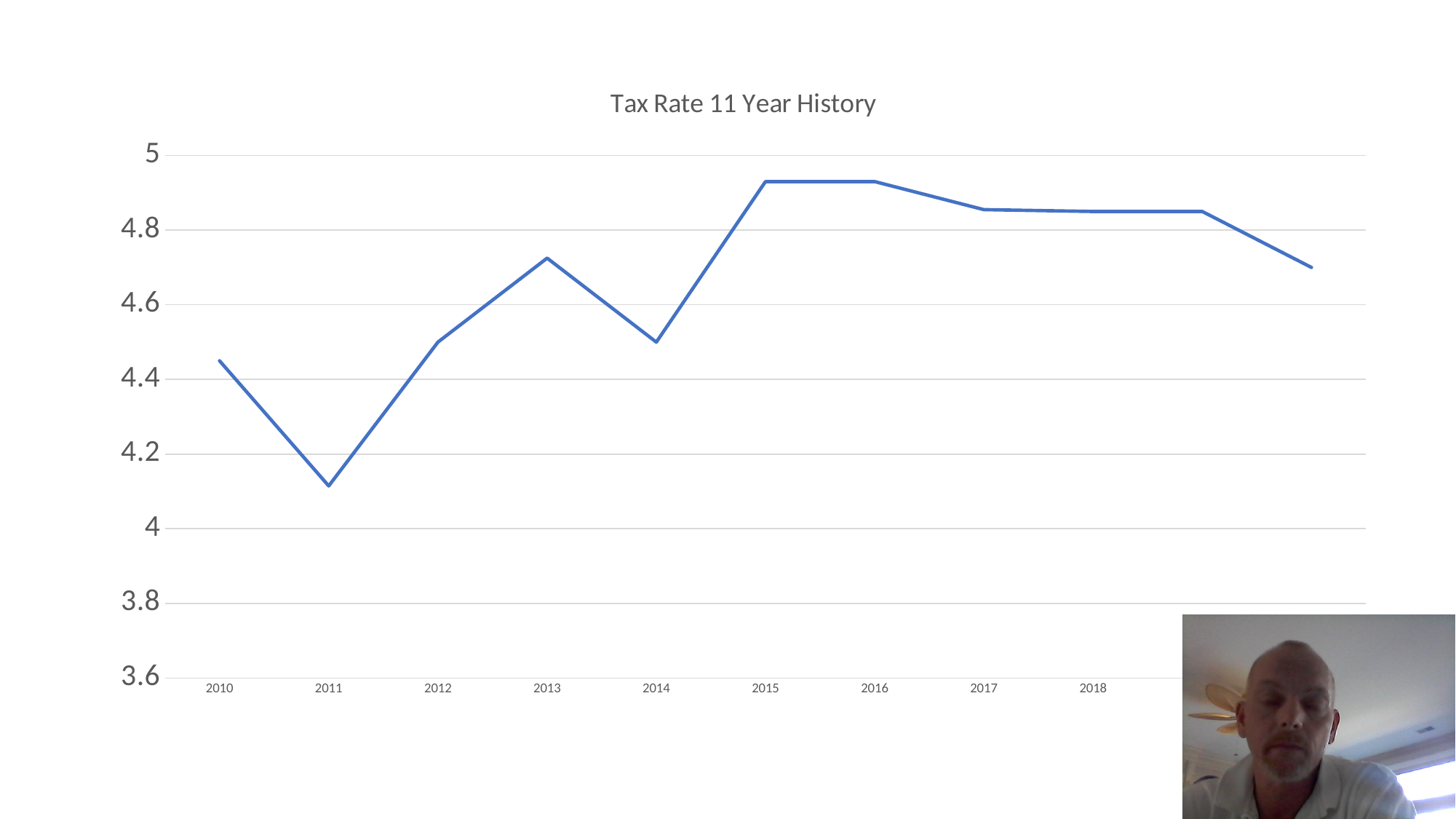
What kind of chart is shown on the slide? line chart Does the tax rate rise or fall from 2010 to 2011? fall Is the value for 2017 greater or less than 4.8? greater Which is larger, the value for 2011 or the value for 2013? 2013 Does the tax rate rise or fall from 2011 to 2013? rise What is the title of the chart? Tax Rate 11 Year History Which is larger, the value for 2010 or the value for 2015? 2015 Is the value for 2011 greater or less than 4.2? less Is the value for 2014 greater or less than 4.6? less Which year has the lowest tax rate on the chart? 2011